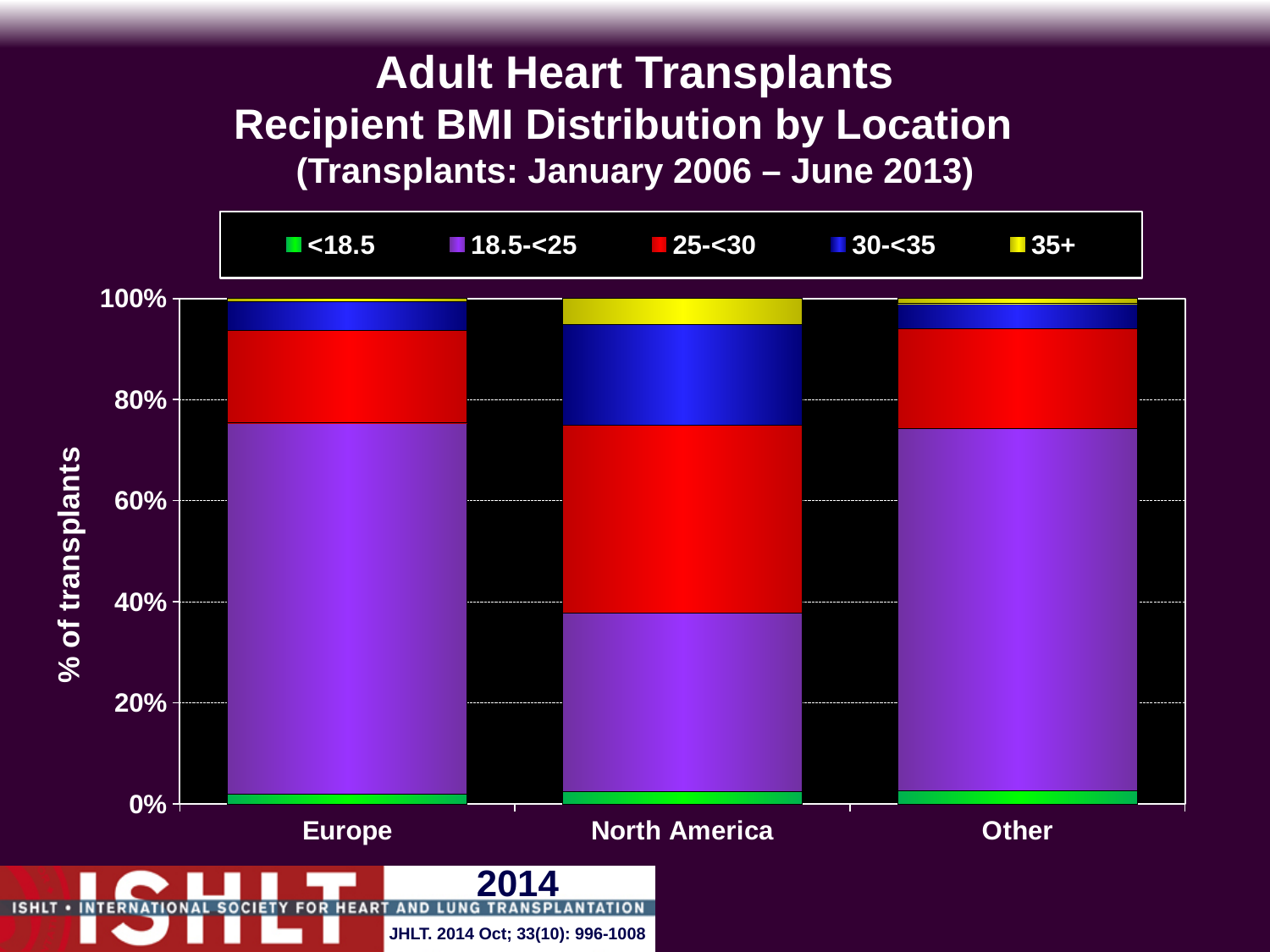
Which location has a larger 35+ share: Europe or North America? North America Which location has a larger 30-<35 share: North America or Other? North America What is the label on the y axis of the chart? % of transplants Which colour represents the 25-<30 BMI category in the legend? Red Is the 18.5-<25 share for Europe larger or smaller than for North America? Larger Is the 18.5-<25 share for Europe greater or less than 60%? greater How many locations are shown on the x axis of the chart? 3 Is the 18.5-<25 share for North America greater or less than 60%? less How many BMI categories does the legend list? 5 Which location has the smallest 18.5-<25 BMI share of transplants? North America Which location has the largest 25-<30 BMI share of transplants? North America What kind of chart is shown on the slide? Stacked bar chart